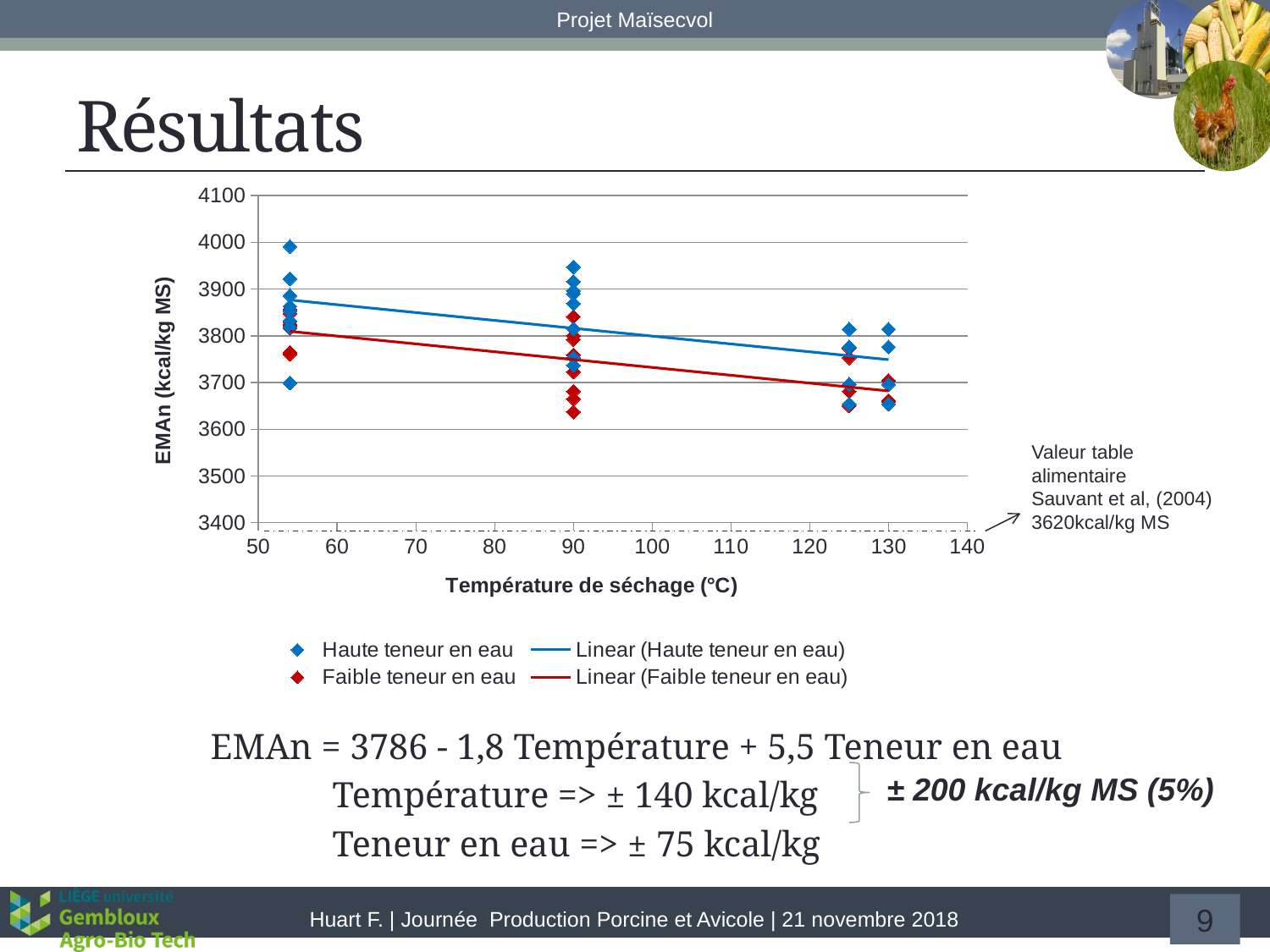
At 130 °C, is the Linear (Faible teneur en eau) trendline greater or less than 3700 kcal/kg MS? less What is the label of the horizontal axis of the chart? Température de séchage (°C) Do the EMAn values rise or fall as the drying temperature increases along the x axis? fall At 130 °C, is the Linear (Haute teneur en eau) trendline greater or less than 3700 kcal/kg MS? greater Is the highest plotted point on the chart greater or less than 3900 kcal/kg MS? greater What is the maximum value shown on the vertical axis of the chart? 4100 How many entries does the chart legend list? 4 What kind of chart is shown on the slide? scatter chart Which series has the higher linear trendline across the chart, Haute teneur en eau or Faible teneur en eau? Haute teneur en eau What is the label of the vertical axis of the chart? EMAn (kcal/kg MS) What reference value from Sauvant et al. (2004) is annotated next to the chart? 3620kcal/kg MS